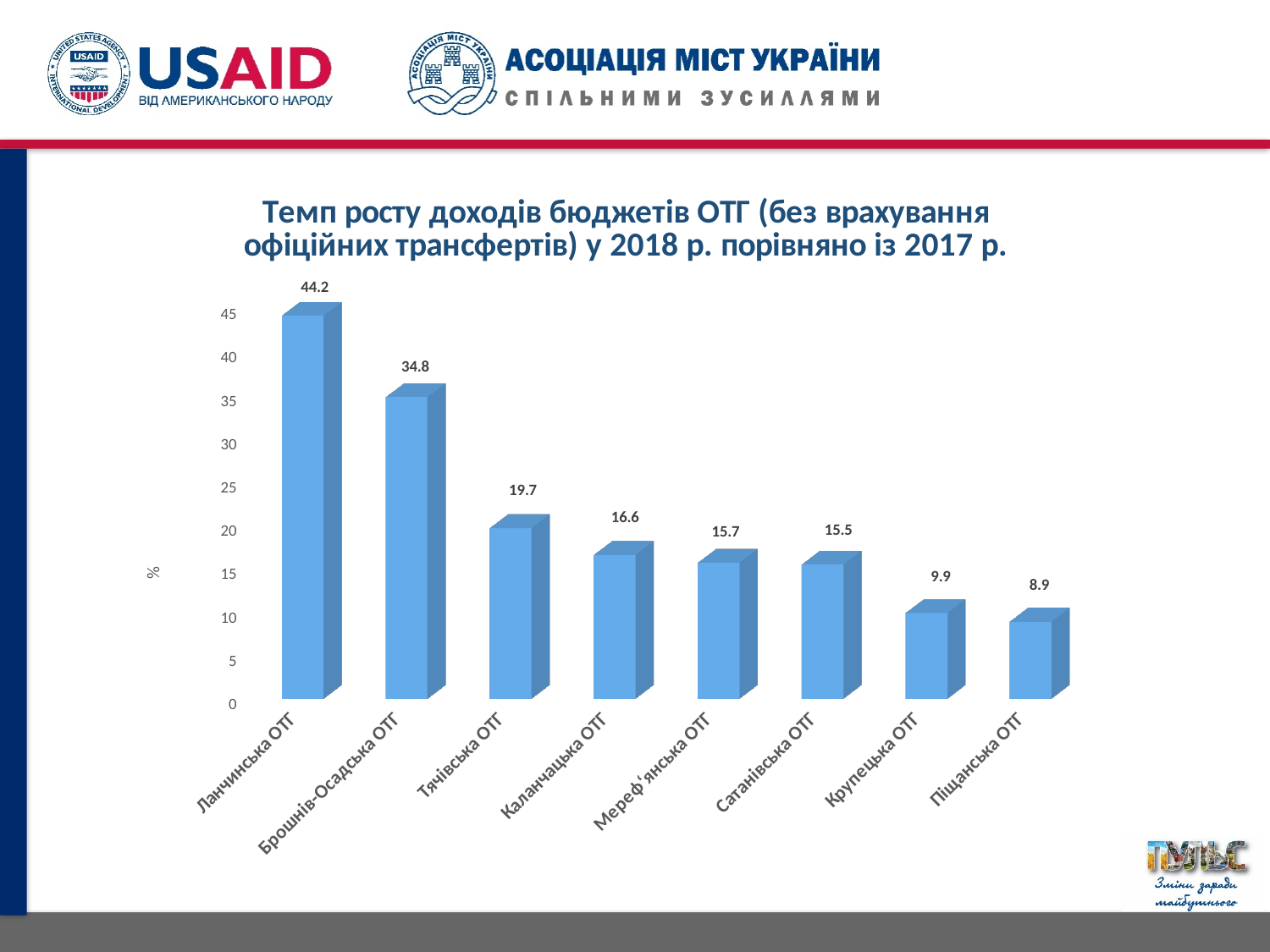
Which category has the highest value? Ланчинська ОТГ What kind of chart is shown on the slide? bar chart Do the values rise or fall from left to right along the x axis? fall Is the value for Мереф'янська ОТГ greater or less than 20? less Which is larger, the value for Каланчацька ОТГ or the value for Сатанівська ОТГ? Каланчацька ОТГ What is the value for Ланчинська ОТГ? 44.2 What unit is shown on the vertical axis label? % Which category has the lowest value? Піщанська ОТГ What is the difference between the values for Ланчинська ОТГ and Брошнів-Осадська ОТГ? 9.4 What is the value for Тячівська ОТГ? 19.7 How many categories are shown on the chart? 8 What is the value for Крупецька ОТГ? 9.9